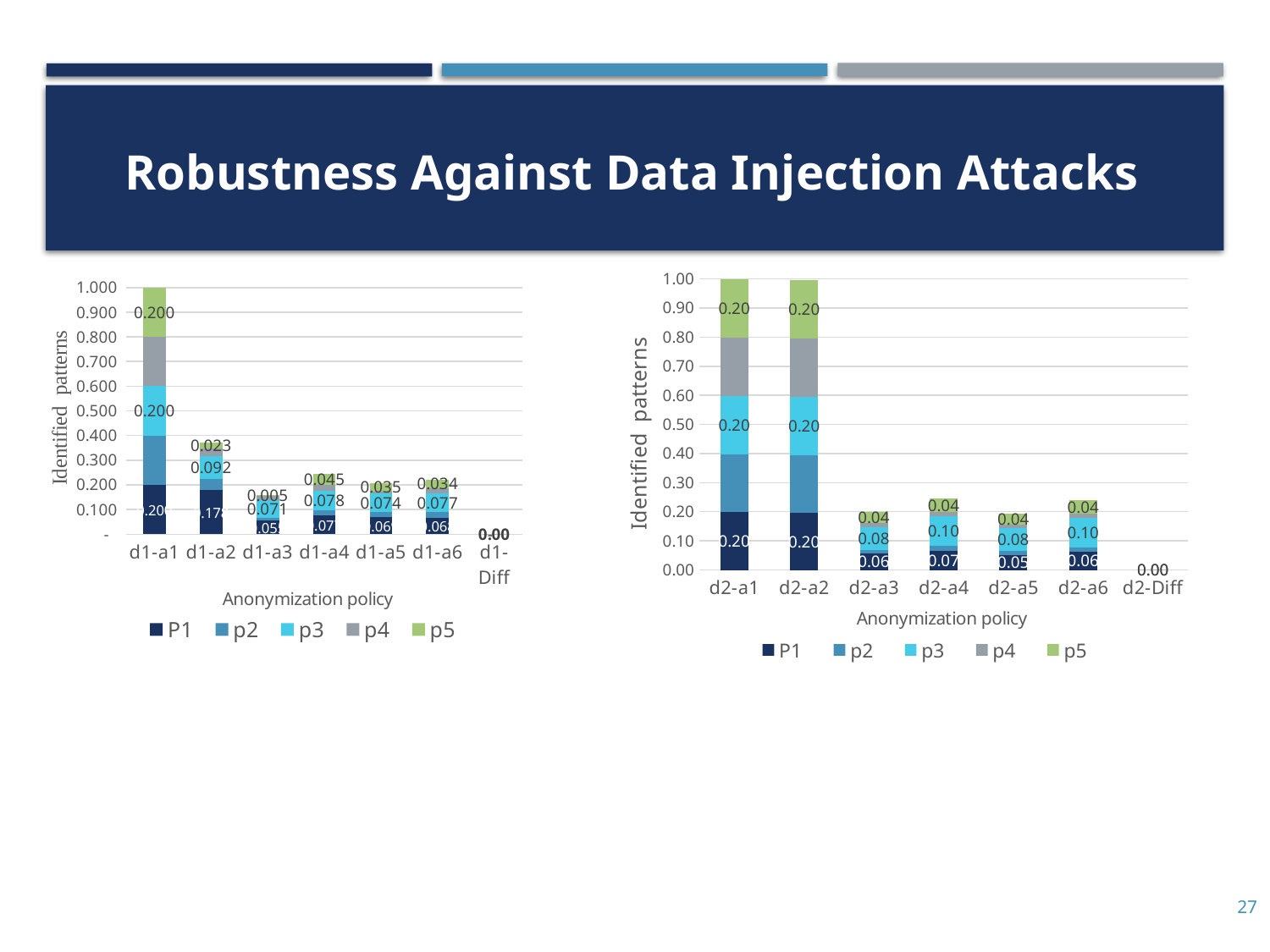
In the right chart, is the total stacked value for d2-a1 greater or less than 0.90? greater In the right chart, which category has the lowest total? d2-Diff In the right chart, what is the difference between the p3 values for d2-a4 and d2-a3? 0.02 How many categories are shown on the x axis of the left chart? 7 In the right chart, which has the taller stacked bar, d2-a4 or d2-a3? d2-a4 In the right chart, what is the value of P1 for d2-a5? 0.05 In the left chart, what is the value of p5 for d1-a4? 0.045 In the right chart, what is the value of p3 for d2-a4? 0.10 How many series does the legend of the right chart list? 5 What kind of chart is the left chart? Stacked bar chart In the right chart, what is the value of p5 for d2-a3? 0.04 In the left chart, what is the value of p3 for d1-a2? 0.092